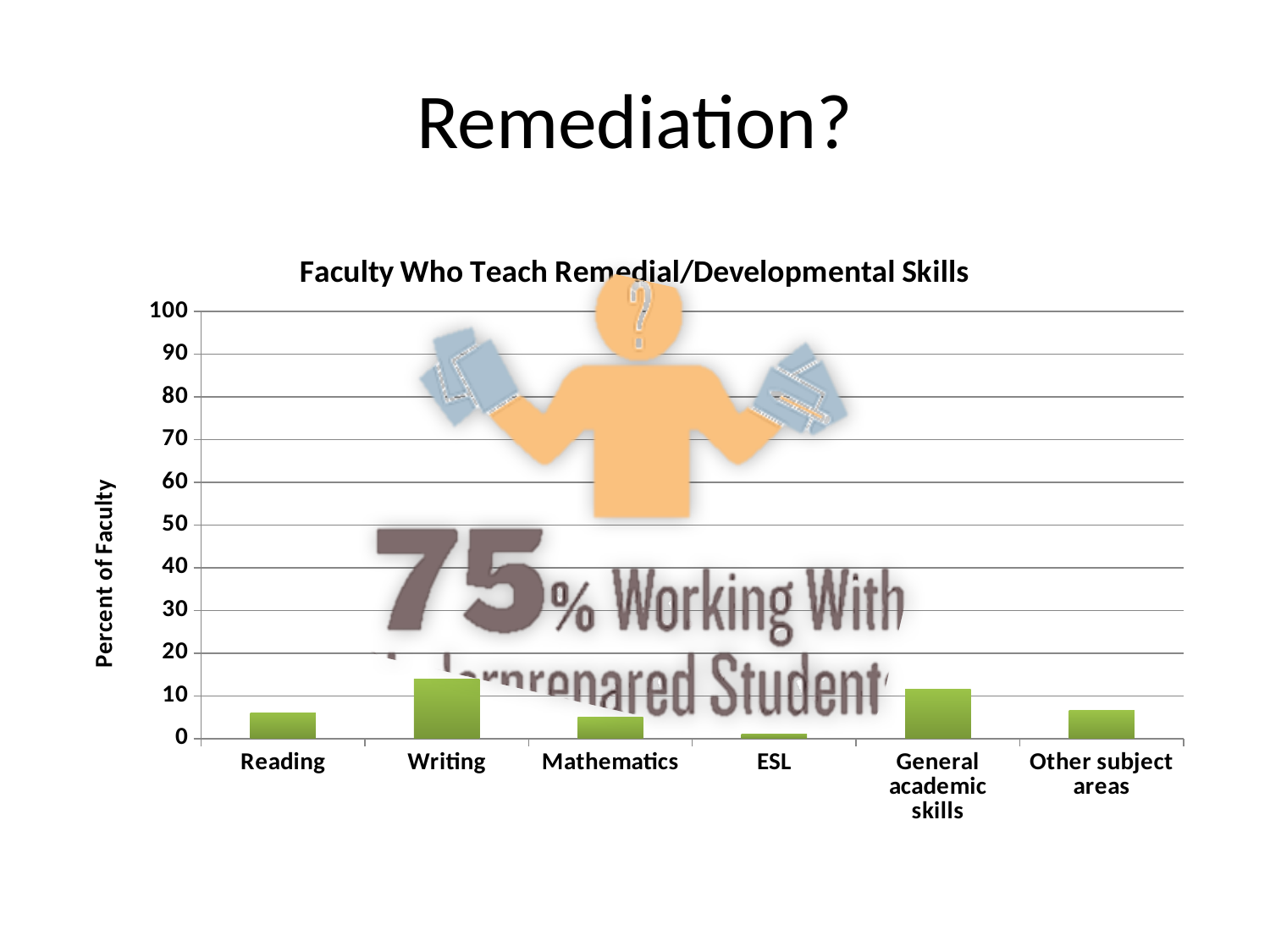
Is the value for ESL greater or less than 10? less Is the value for Reading greater or less than 10? less Which is larger, the value for Mathematics or the value for General academic skills? General academic skills How many categories are shown on the x axis of the chart? 6 What is the title of the chart? Faculty Who Teach Remedial/Developmental Skills What is the label on the vertical axis of the chart? Percent of Faculty Which is larger, the value for Writing or the value for Reading? Writing Is the value for Writing greater or less than 20? less Which category has the lowest value in the chart? ESL Which category has the highest value in the chart? Writing What type of chart is shown on the slide? bar chart